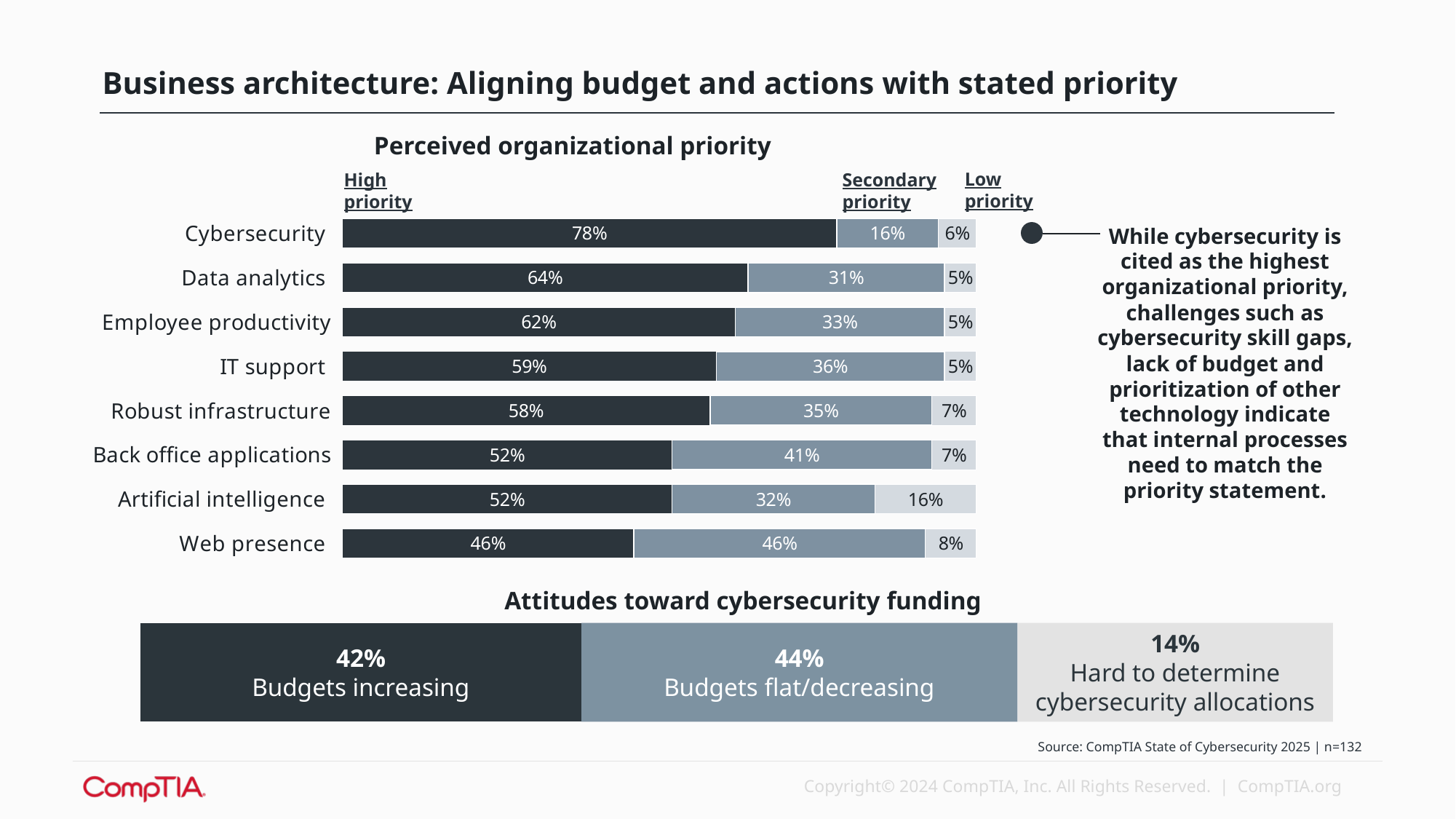
In the 'Perceived organizational priority' chart, what is the secondary priority value for Back office applications? 41% In the 'Perceived organizational priority' chart, which category has the highest high priority value? Cybersecurity In the 'Perceived organizational priority' chart, which has a larger secondary priority value, IT support or Robust infrastructure? IT support In the 'Perceived organizational priority' chart, what percentage rate Cybersecurity as a high priority? 78% What kind of chart is the 'Perceived organizational priority' chart? Stacked bar chart In the 'Perceived organizational priority' chart, what is the low priority value for Artificial intelligence? 16% In the 'Attitudes toward cybersecurity funding' chart, what percentage report budgets increasing? 42% In the 'Perceived organizational priority' chart, what is the difference between the high priority values for Cybersecurity and Data analytics? 14% How many series does the 'Perceived organizational priority' chart show? 3 In the 'Perceived organizational priority' chart, which category has the lowest high priority value? Web presence In the 'Attitudes toward cybersecurity funding' chart, which segment is the largest? Budgets flat/decreasing How many categories are shown in the 'Perceived organizational priority' chart? 8